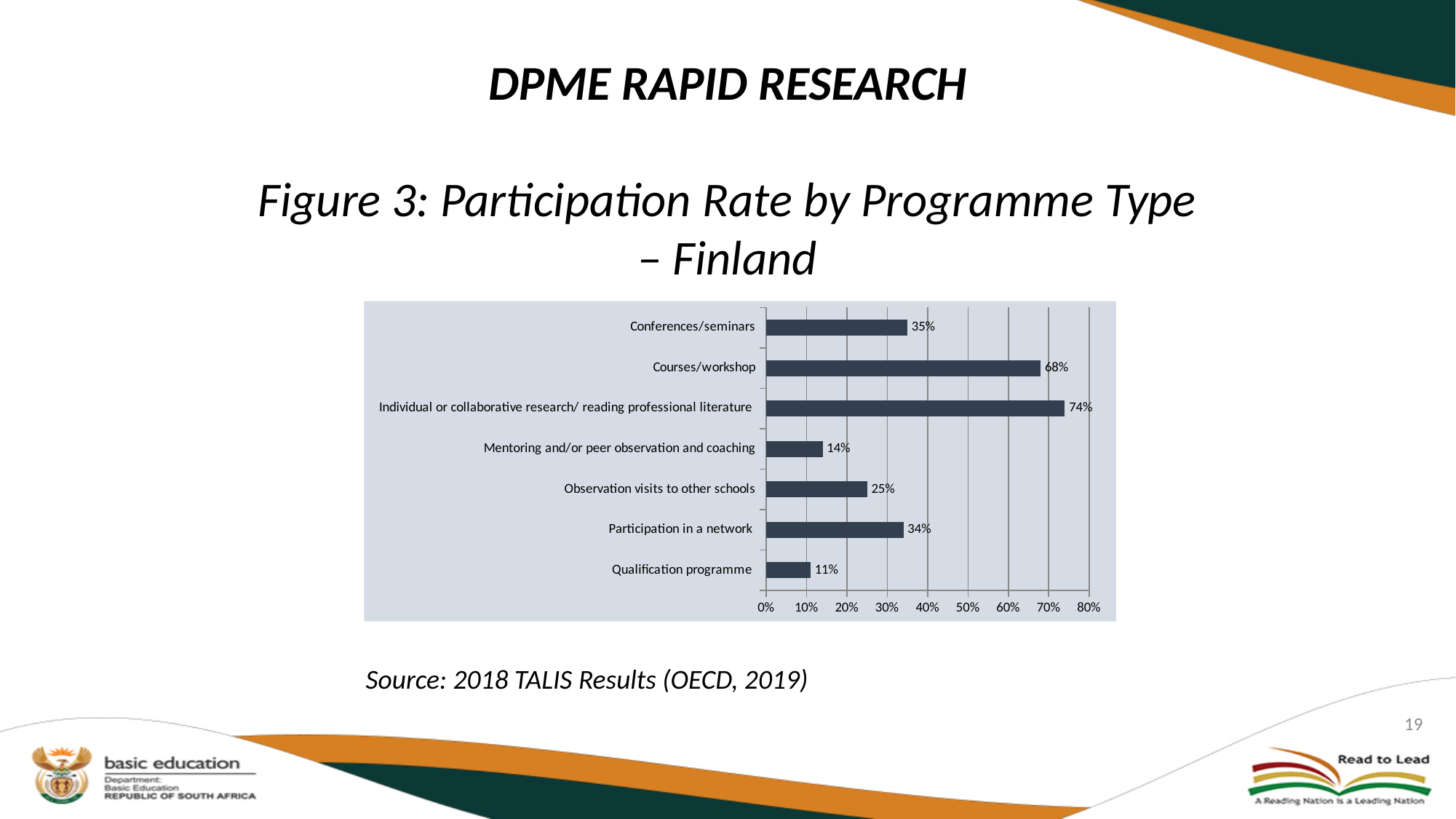
What is the participation rate for Courses/workshop? 68% Which programme type has the highest participation rate? Individual or collaborative research/ reading professional literature What is the maximum value shown on the x axis of the chart? 80% What is the difference between the participation rates for Participation in a network and Qualification programme? 23% What is the difference between the participation rates for Courses/workshop and Conferences/seminars? 33% Which programme type has the lowest participation rate? Qualification programme How many programme types are shown in the chart? 7 Is the participation rate for Individual or collaborative research/ reading professional literature greater or less than 70%? greater Which has a higher participation rate, Observation visits to other schools or Mentoring and/or peer observation and coaching? Observation visits to other schools What is the participation rate for Mentoring and/or peer observation and coaching? 14% What kind of chart is shown on the slide? Bar chart What is the participation rate for Observation visits to other schools? 25%